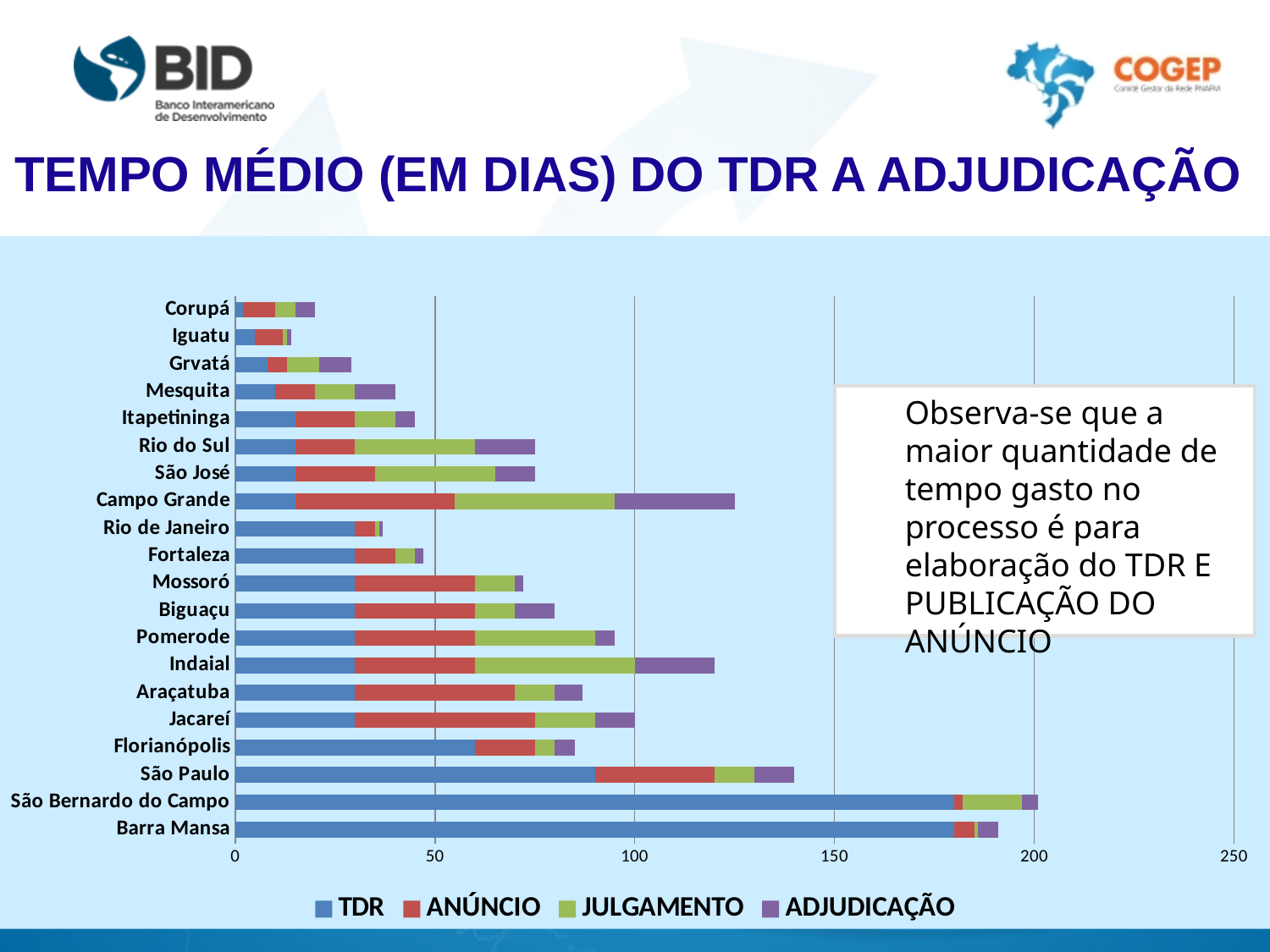
Which city has a longer total bar, Jacareí or Florianópolis? Jacareí How many cities are listed on the vertical axis of the chart? 20 Which city has a longer total bar, São Paulo or Campo Grande? São Paulo Which city has the longest total bar in the chart? São Bernardo do Campo Is the total bar for Campo Grande greater or less than 100? greater Is the total bar for Corupá greater or less than 50? less Is the TDR segment for Barra Mansa greater or less than 150? greater Which series are listed in the chart legend? TDR, ANÚNCIO, JULGAMENTO, ADJUDICAÇÃO How many series does the chart legend list? 4 What is the title of the chart on the slide? TEMPO MÉDIO (EM DIAS) DO TDR A ADJUDICAÇÃO What kind of chart is shown on the slide? Stacked bar chart Which city has the shortest total bar in the chart? Iguatu